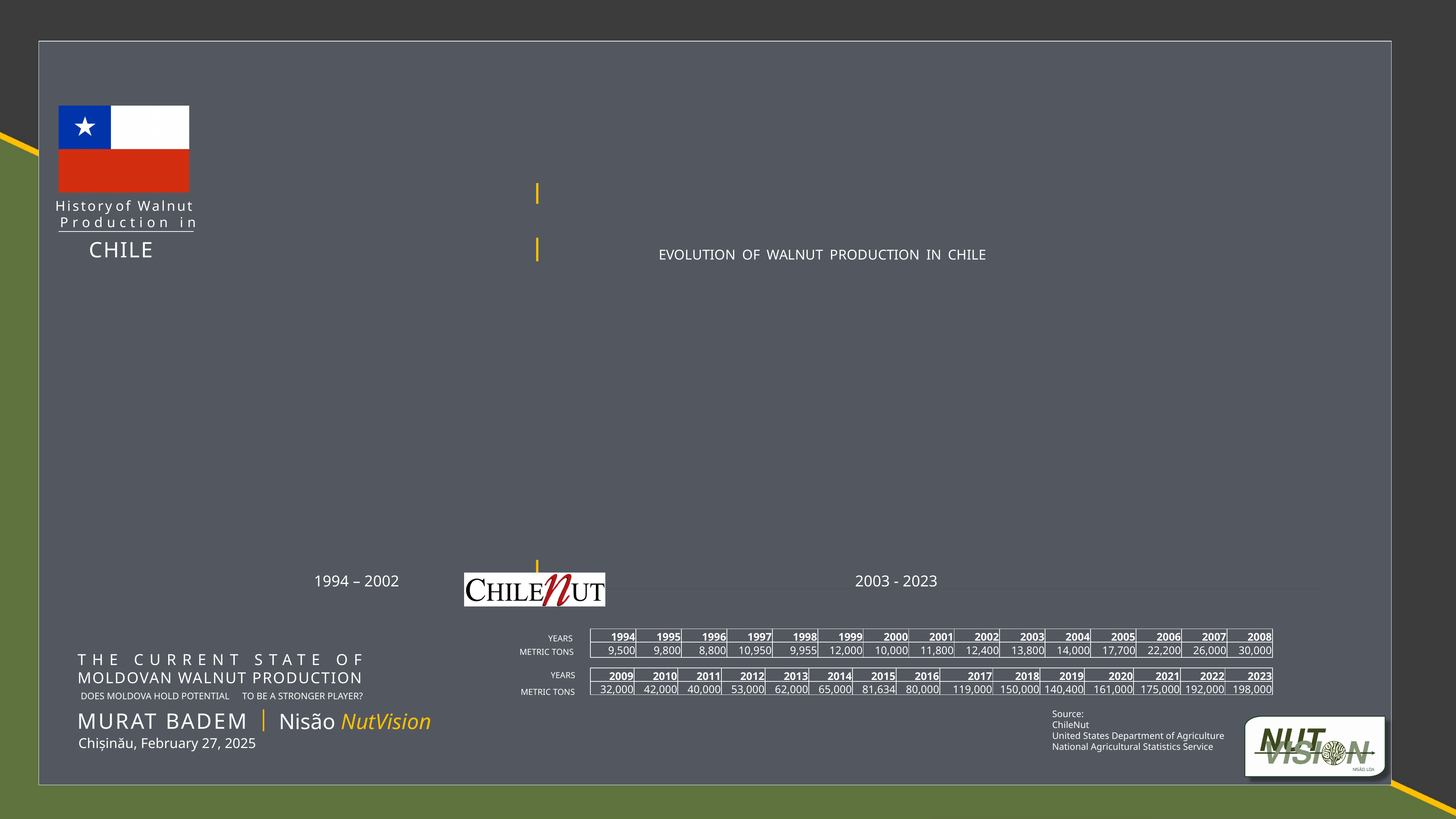
What is the title shown above the walnut production data on the slide? EVOLUTION OF WALNUT PRODUCTION IN CHILE In the Evolution of Walnut Production in Chile data table, which year has the highest metric tons value? 2023 In the Evolution of Walnut Production in Chile data table, what is the metric tons value for 2008? 30,000 In the Evolution of Walnut Production in Chile data table, what is the metric tons value for 1994? 9,500 In the Evolution of Walnut Production in Chile data table, which year has the larger metric tons value, 2018 or 2019? 2018 In the Evolution of Walnut Production in Chile data table, what is the difference in metric tons between 2023 and 2022? 6,000 In the Evolution of Walnut Production in Chile data table, what is the metric tons value for 2015? 81,634 How many years are listed in the Evolution of Walnut Production in Chile data table? 30 In the Evolution of Walnut Production in Chile data table, which year has the larger metric tons value, 2010 or 2011? 2010 In the Evolution of Walnut Production in Chile data table, which year has the lowest metric tons value? 1996 In the Evolution of Walnut Production in Chile data table, what is the difference in metric tons between 2018 and 2019? 9,600 In the Evolution of Walnut Production in Chile data table, what is the metric tons value for 2023? 198,000